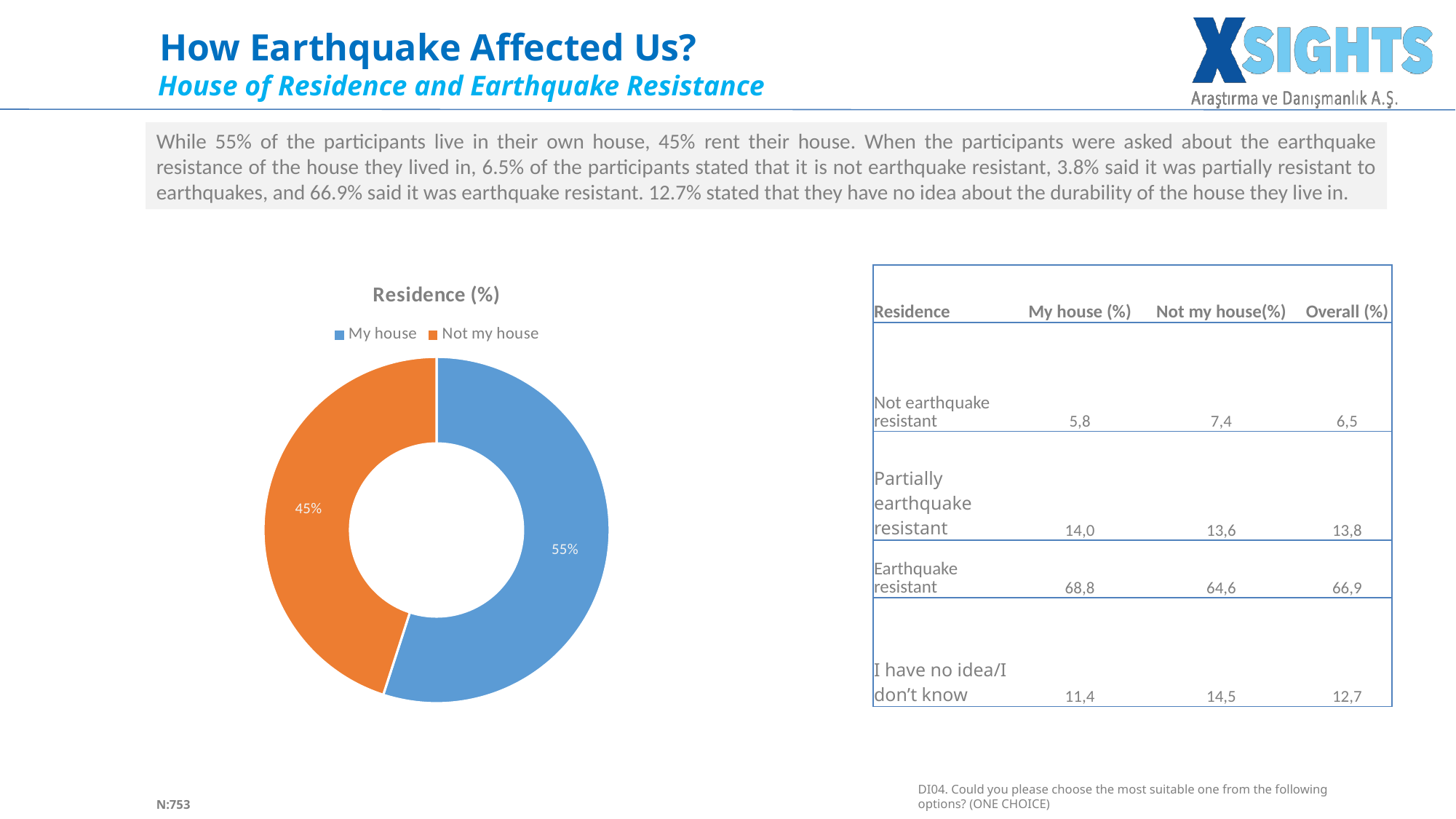
What is the title of the chart on the slide? Residence (%) How many entries does the legend of the Residence (%) chart list? 2 What do the two slices of the Residence (%) chart add up to? 100% Which category has the smallest slice in the Residence (%) chart? Not my house In the Residence (%) chart, which is larger: My house or Not my house? My house In the Residence (%) chart, what percentage is shown for Not my house? 45% How many slices does the Residence (%) chart have? 2 In the Residence (%) chart, what percentage is shown for My house? 55% Which category has the largest slice in the Residence (%) chart? My house What kind of chart is the Residence (%) chart? Doughnut chart In the Residence (%) chart, by how many percentage points does My house exceed Not my house? 10 percentage points What colour is the My house slice in the Residence (%) chart? Blue